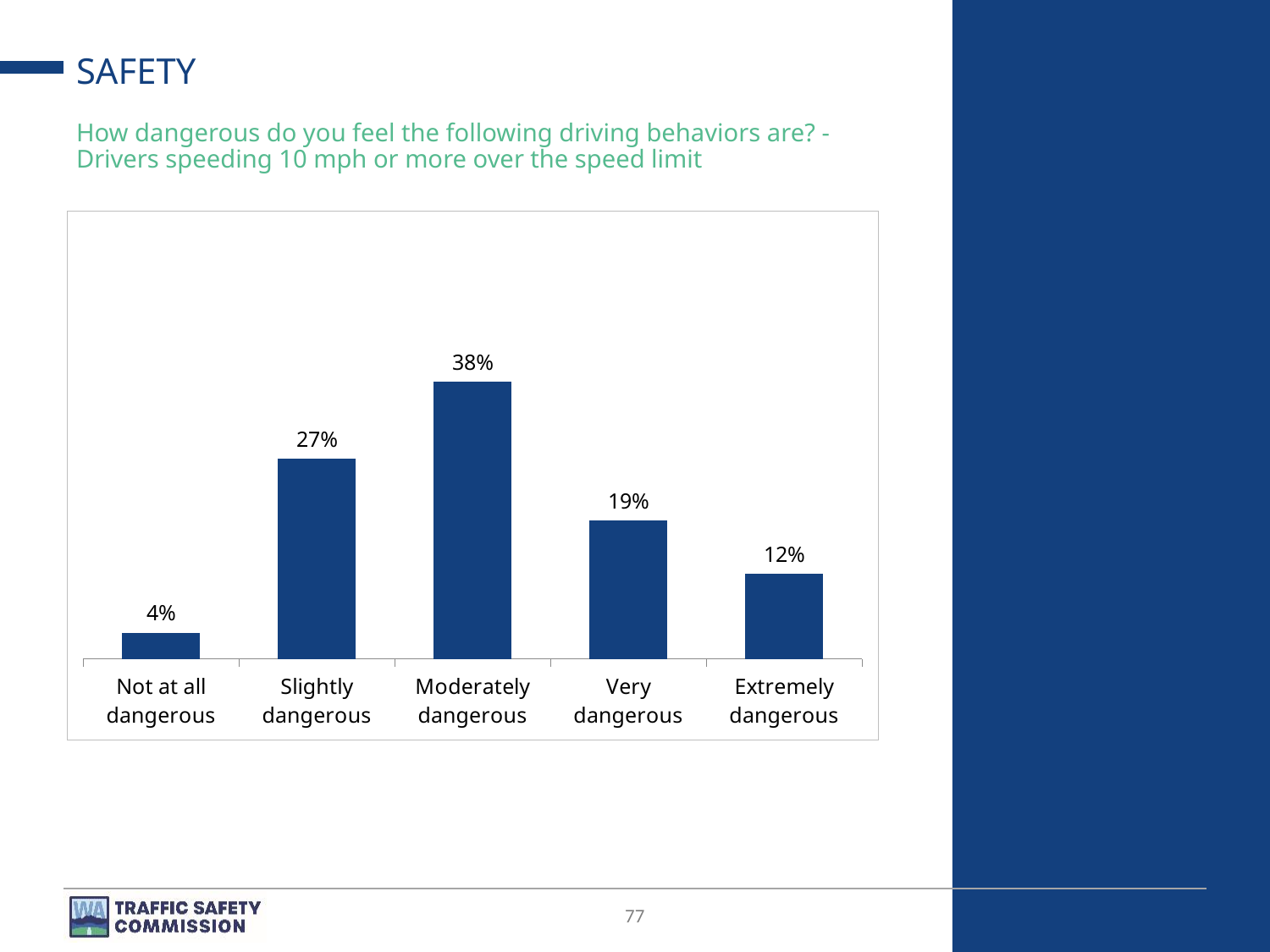
What kind of chart is shown on the slide? Bar chart What is the value for "Very dangerous"? 19% What driving behavior does the chart's question ask about? Drivers speeding 10 mph or more over the speed limit Which category has the lowest value? Not at all dangerous Which category has the highest value? Moderately dangerous How many categories are shown on the x axis? 5 What percentage of respondents said speeding 10 mph or more over the limit is "Moderately dangerous"? 38% What is the difference between the "Moderately dangerous" and "Slightly dangerous" values? 11% Which is larger, the value for "Slightly dangerous" or the value for "Very dangerous"? Slightly dangerous What is the difference between the "Very dangerous" and "Extremely dangerous" values? 7% What is the value shown for "Not at all dangerous"? 4% What percentage is shown for "Extremely dangerous"? 12%